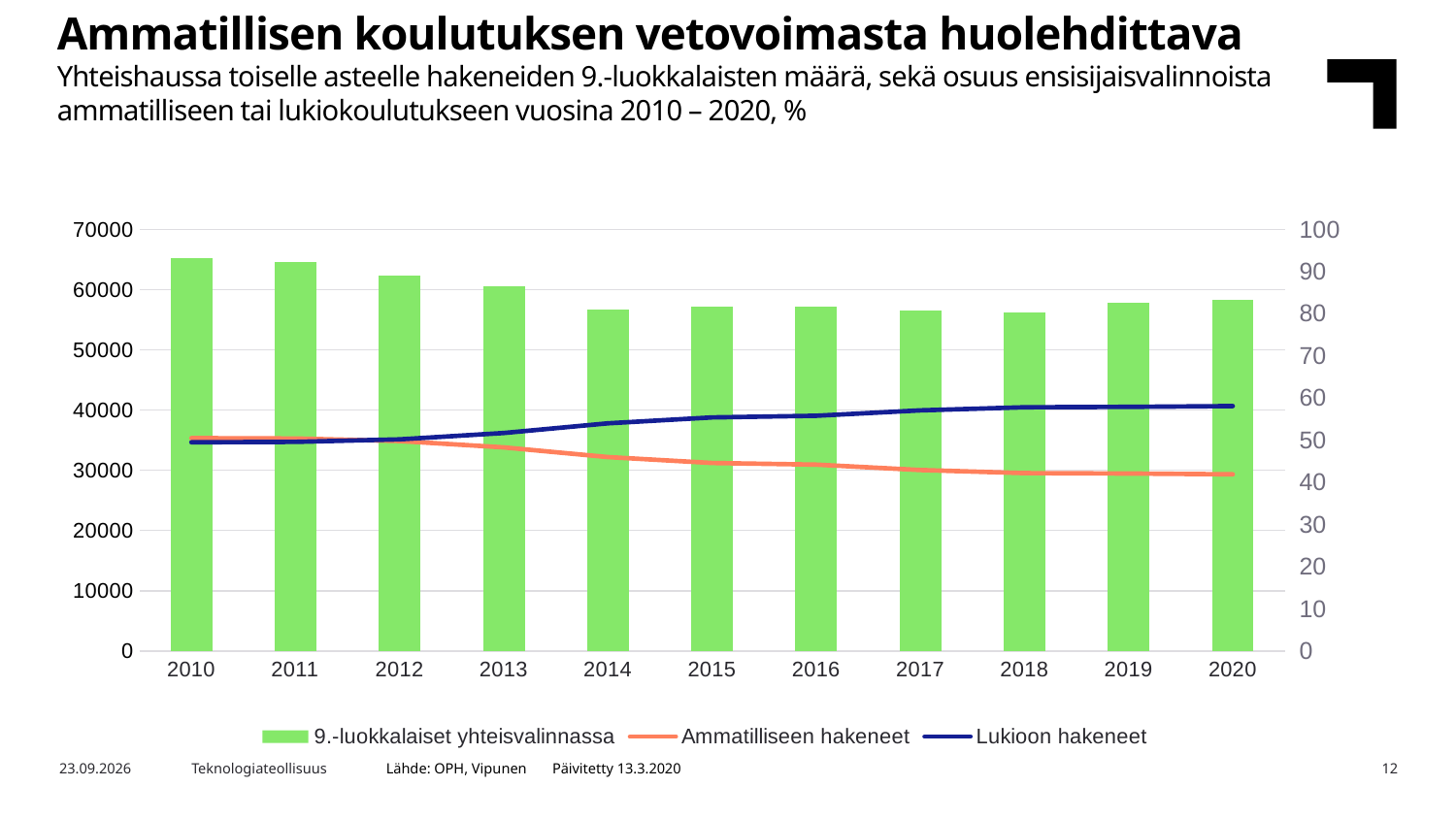
Does the Ammatilliseen hakeneet line rise or fall from 2010 to 2020? Fall In 2020, which line is higher: Ammatilliseen hakeneet or Lukioon hakeneet? Lukioon hakeneet What kind of chart is shown on the slide? A combined bar and line chart Which is larger: the bar for 2010 or the bar for 2020? 2010 Is the bar value for 9.-luokkalaiset yhteisvalinnassa in 2010 greater or less than 60000? greater What colour are the bars for 9.-luokkalaiset yhteisvalinnassa? Green Is the value of the Ammatilliseen hakeneet line in 2020 greater or less than 50? less How many years are shown on the x axis of the chart? 11 Is the bar value for 9.-luokkalaiset yhteisvalinnassa in 2020 greater or less than 60000? less How many series does the chart legend list? 3 Which year has the highest bar for 9.-luokkalaiset yhteisvalinnassa? 2010